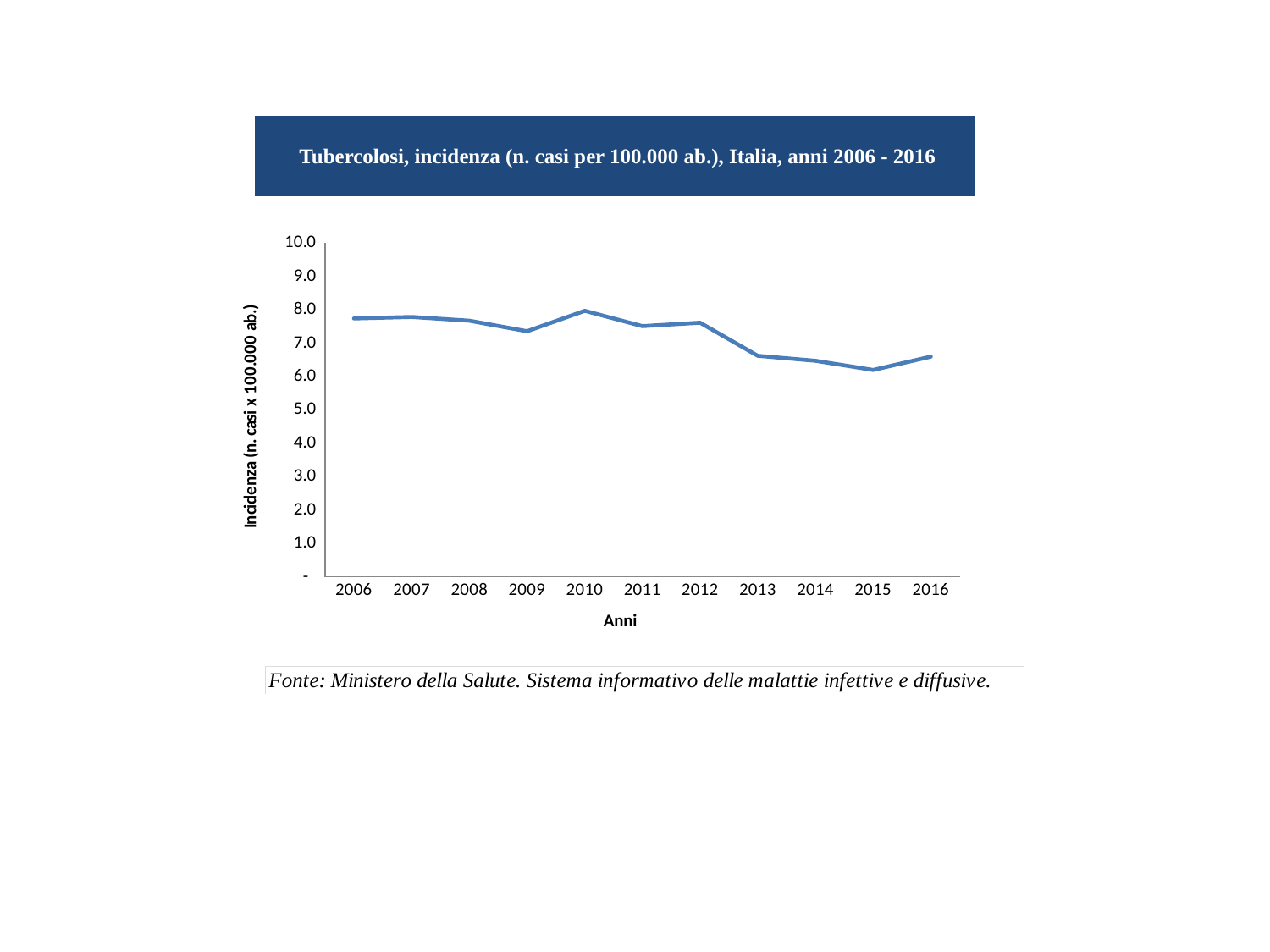
What is the label of the x axis? Anni What kind of chart is shown on the slide? Line chart How many years are plotted along the x axis? 11 Which year has the larger incidence, 2012 or 2013? 2012 Is the value for 2015 greater or less than 7.0? less Is the value for 2006 greater or less than 8.0? less Which year has the lowest tuberculosis incidence? 2015 Overall, does the incidence rise or fall from 2006 to 2016? Fall Is the value for 2013 greater or less than 6.0? greater What is the title of the chart? Tubercolosi, incidenza (n. casi per 100.000 ab.), Italia, anni 2006 - 2016 Which year has the highest tuberculosis incidence? 2010